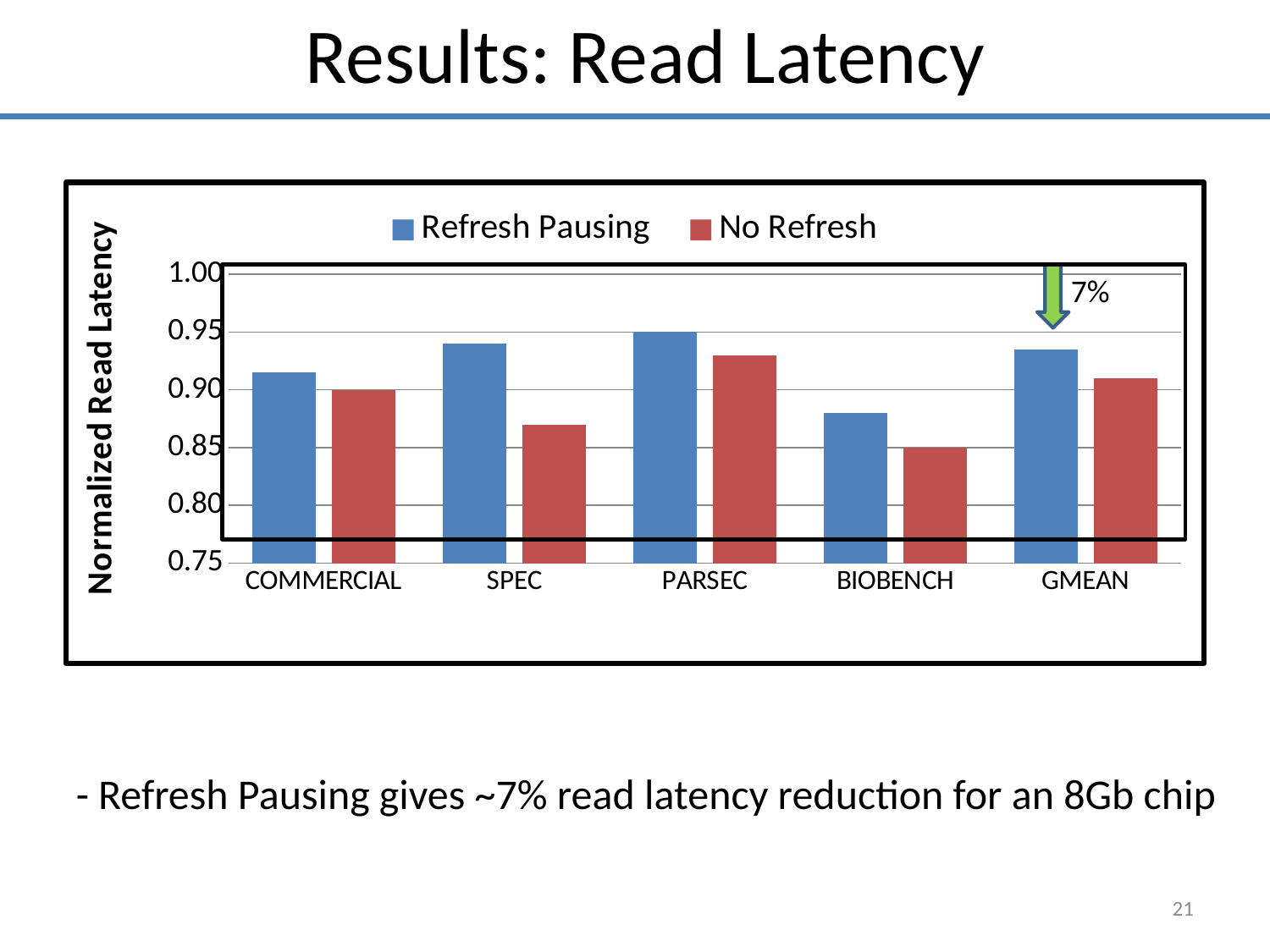
Which category has the highest No Refresh value? PARSEC Is the No Refresh value for SPEC greater or less than 0.90? less Which category has the lowest No Refresh value? BIOBENCH What is the label of the y axis? Normalized Read Latency What kind of chart is shown on the slide? bar chart Is the Refresh Pausing value for BIOBENCH greater or less than 0.90? less How many series does the legend list? 2 Which category has the lowest Refresh Pausing value? BIOBENCH For SPEC, which is larger: the Refresh Pausing value or the No Refresh value? Refresh Pausing How many categories are shown on the x axis? 5 Which category has the highest Refresh Pausing value? PARSEC Is the Refresh Pausing value for GMEAN greater or less than 0.90? greater